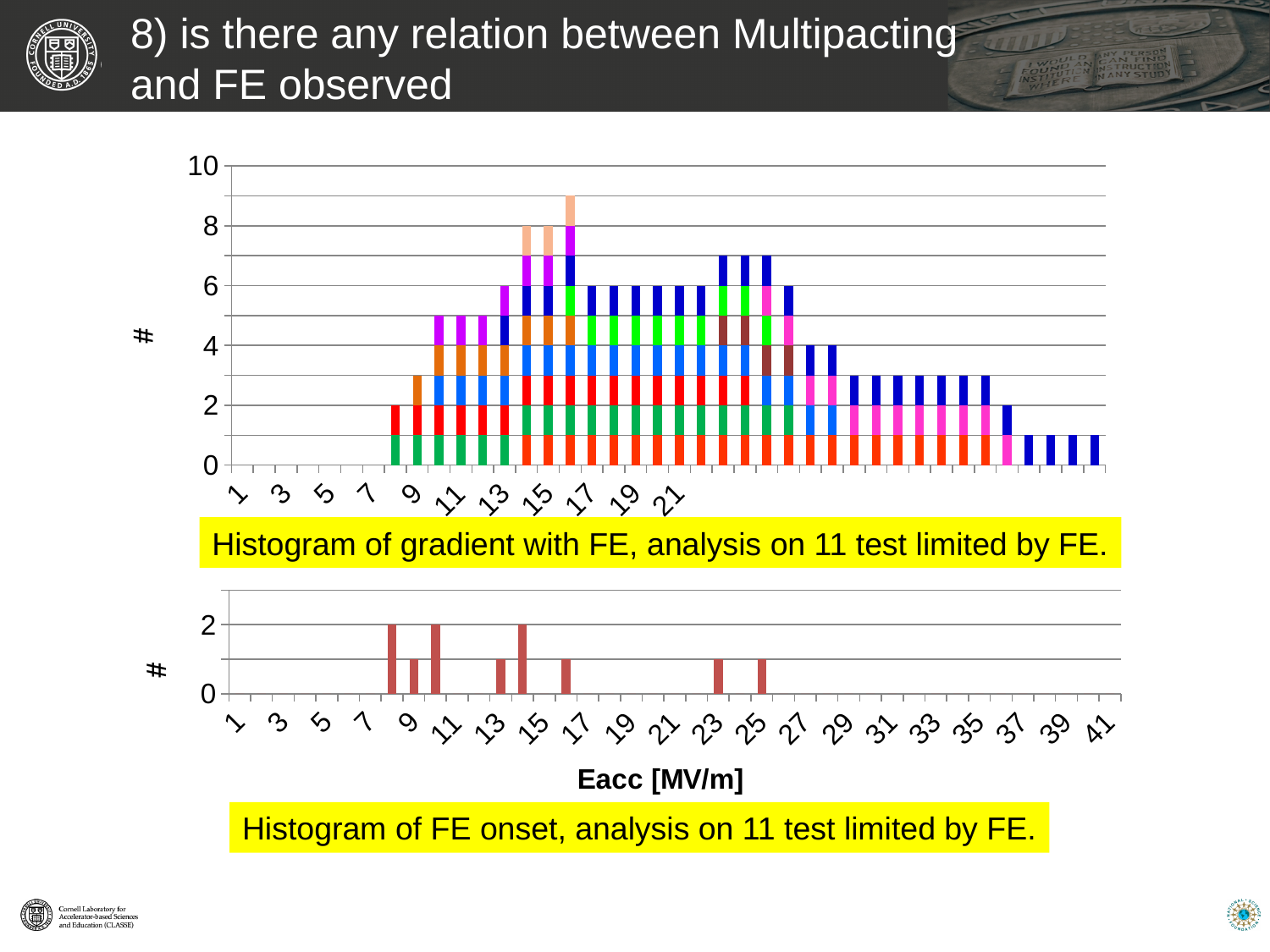
In the bottom chart (Histogram of FE onset), how many bars are plotted? 8 In the top chart (Histogram of gradient with FE), is the value at Eacc = 9 greater or less than 4? less In the bottom chart (Histogram of FE onset), what is the value at Eacc = 25? 1 In the bottom chart (Histogram of FE onset), what is the highest value reached by any bar? 2 In the top chart (Histogram of gradient with FE), what is the value at Eacc = 13? 6 In the top chart (Histogram of gradient with FE), is the tallest bar greater or less than 8? greater In the top chart (Histogram of gradient with FE), which has the larger value, Eacc = 9 or Eacc = 15? Eacc = 15 In the bottom chart (Histogram of FE onset), what is the value at Eacc = 9? 1 In the top chart (Histogram of gradient with FE), what is the value at Eacc = 15? 8 What kind of chart is the bottom chart (Histogram of FE onset)? bar chart In the bottom chart (Histogram of FE onset), what is the value at Eacc = 23? 1 What is the x-axis title shown below the bottom chart? Eacc [MV/m]